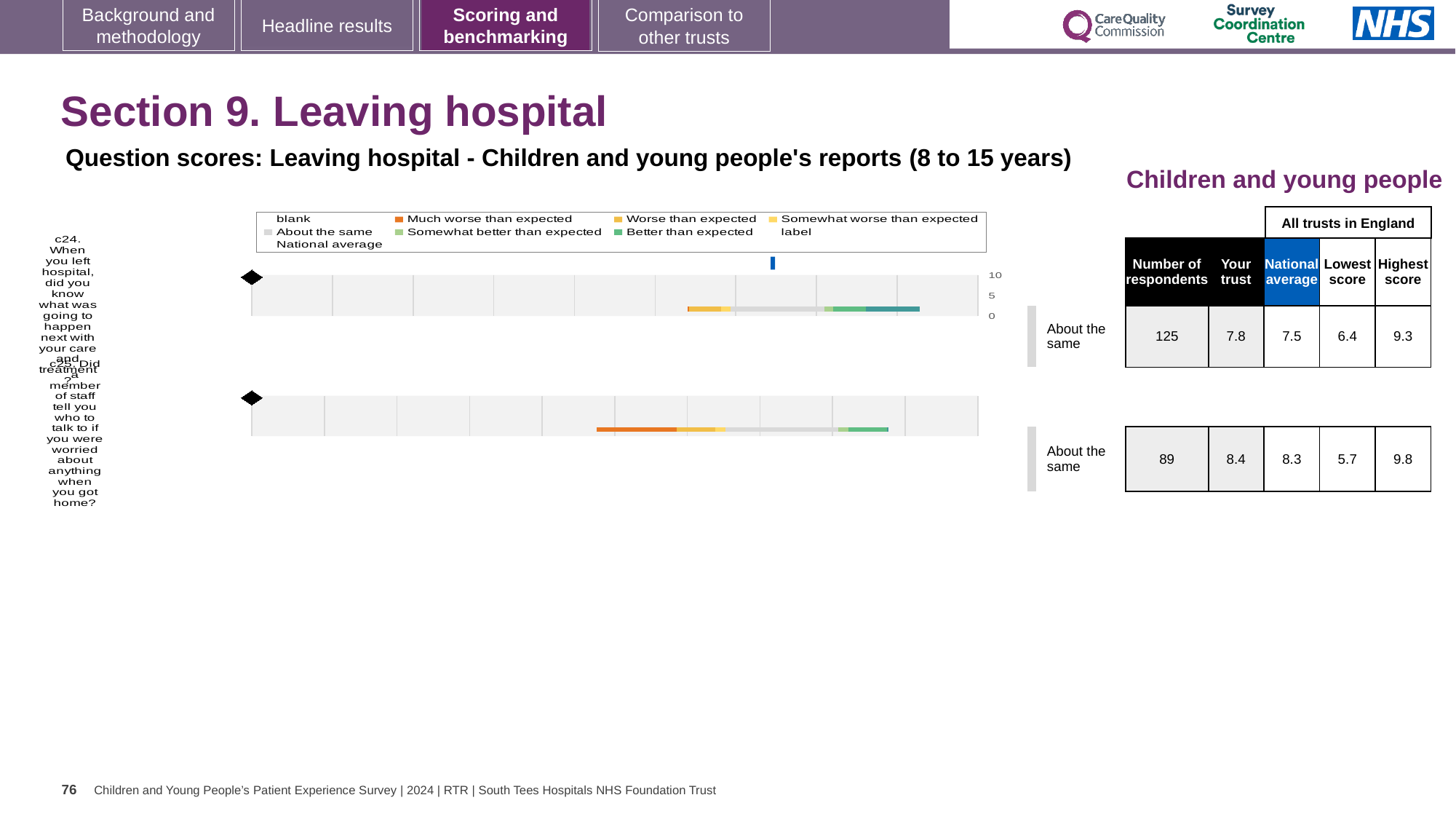
What type of chart is used to show the question scores for c24 and c25? bar chart In the legend, which colour represents 'Much worse than expected'? orange What is the 'Your trust' score for question c24 (When you left hospital, did you know what was going to happen next with your care and treatment?)? 7.8 Is the 'Your trust' score for question c25 greater or less than the national average for that question? greater What is the difference between the highest score and the lowest score for question c24? 2.9 How many questions (c24 and c25) are plotted on the slide? 2 What benchmark category is shown for question c25? About the same Which question has the higher 'Your trust' score, c24 or c25? c25 What is the national average score for question c25 (Did a member of staff tell you who to talk to if you were worried about anything when you got home?)? 8.3 Is the 'Your trust' score for question c24 greater or less than 5 on the chart axis? greater How many respondents answered question c24? 125 What is the highest score among all trusts in England for question c25? 9.8